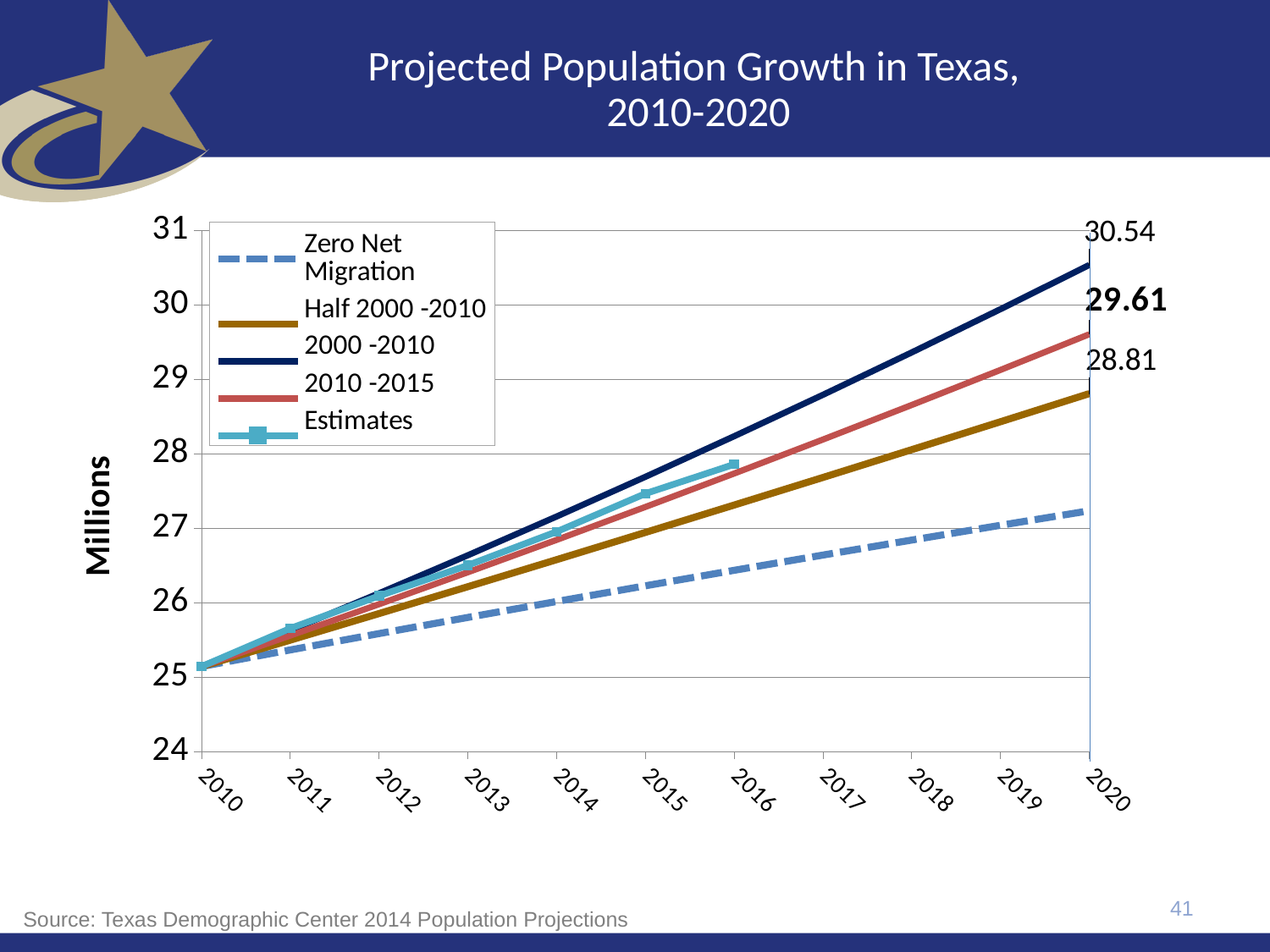
How many series does the legend list? 5 What is the difference between the 2000 -2010 and Half 2000 -2010 values in 2020? 1.73 Is the value for Zero Net Migration in 2020 greater or less than 28? less Which series has the highest value in 2020? 2000 -2010 What is the projected value for the 2010 -2015 series in 2020? 29.61 Which series has the lowest value in 2020? Zero Net Migration What is the projected value for the 2000 -2010 series in 2020? 30.54 What is the label on the y axis? Millions What kind of chart is shown on the slide? line chart What is the projected value for the Half 2000 -2010 series in 2020? 28.81 Do the projected values rise or fall from 2010 to 2020? rise What is the difference between the 2000 -2010 and 2010 -2015 values in 2020? 0.93